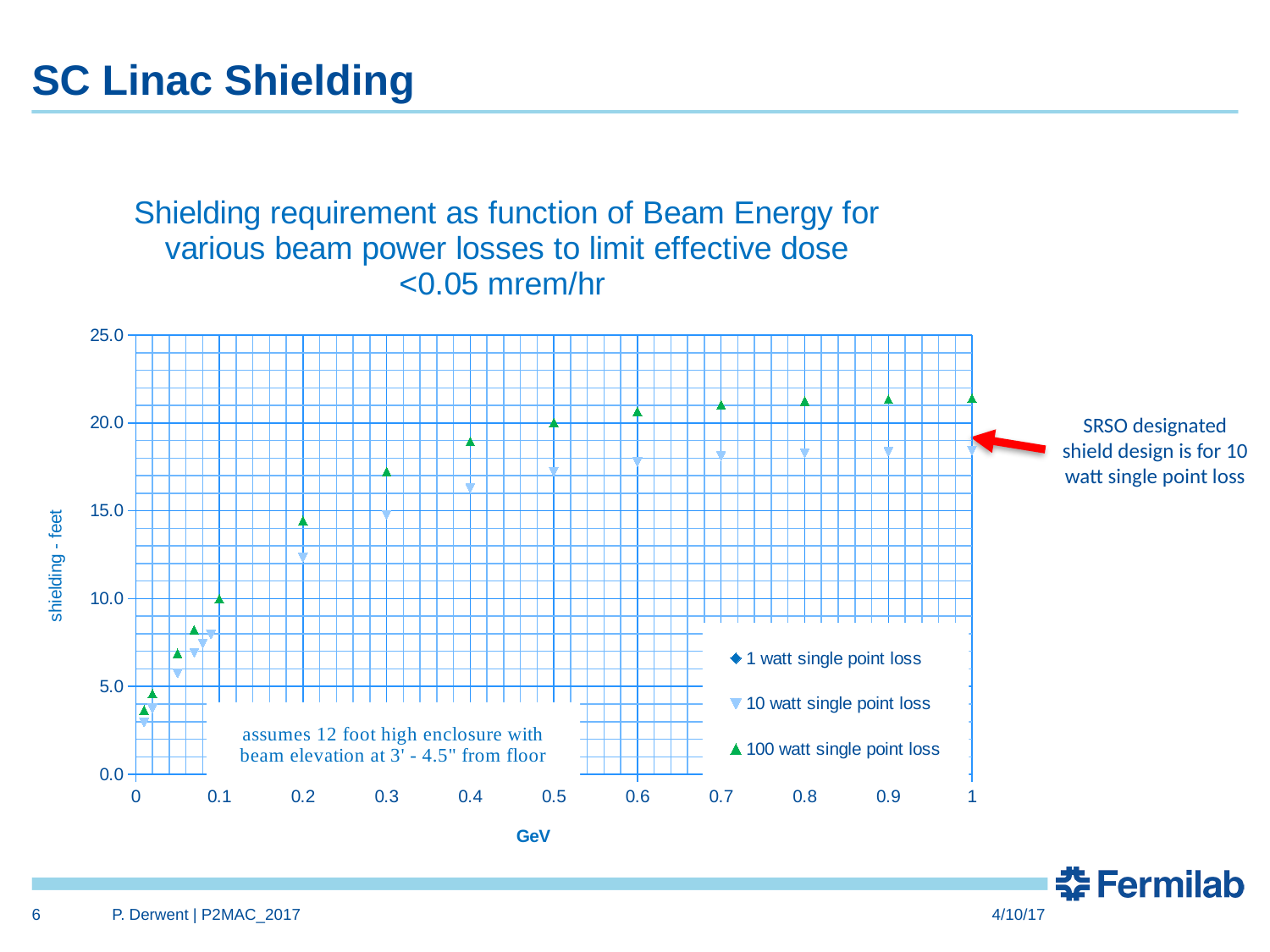
Is the shielding value for the 10 watt single point loss series at 1 GeV greater or less than 20.0 feet? less Is the shielding value for the 10 watt single point loss series at 0.2 GeV greater or less than 10.0 feet? greater Is the shielding value for the 100 watt single point loss series at 0.2 GeV greater or less than 15.0 feet? less Does the shielding requirement for the 100 watt single point loss series rise or fall as beam energy increases along the x axis? rise How many series does the chart legend list? 3 Which series shows the highest shielding requirement across the chart? 100 watt single point loss At 0.5 GeV, which series requires more shielding: 10 watt single point loss or 100 watt single point loss? 100 watt single point loss What is the label of the chart's x axis? GeV What is the label of the chart's y axis? shielding - feet What kind of chart is shown on the slide? scatter chart